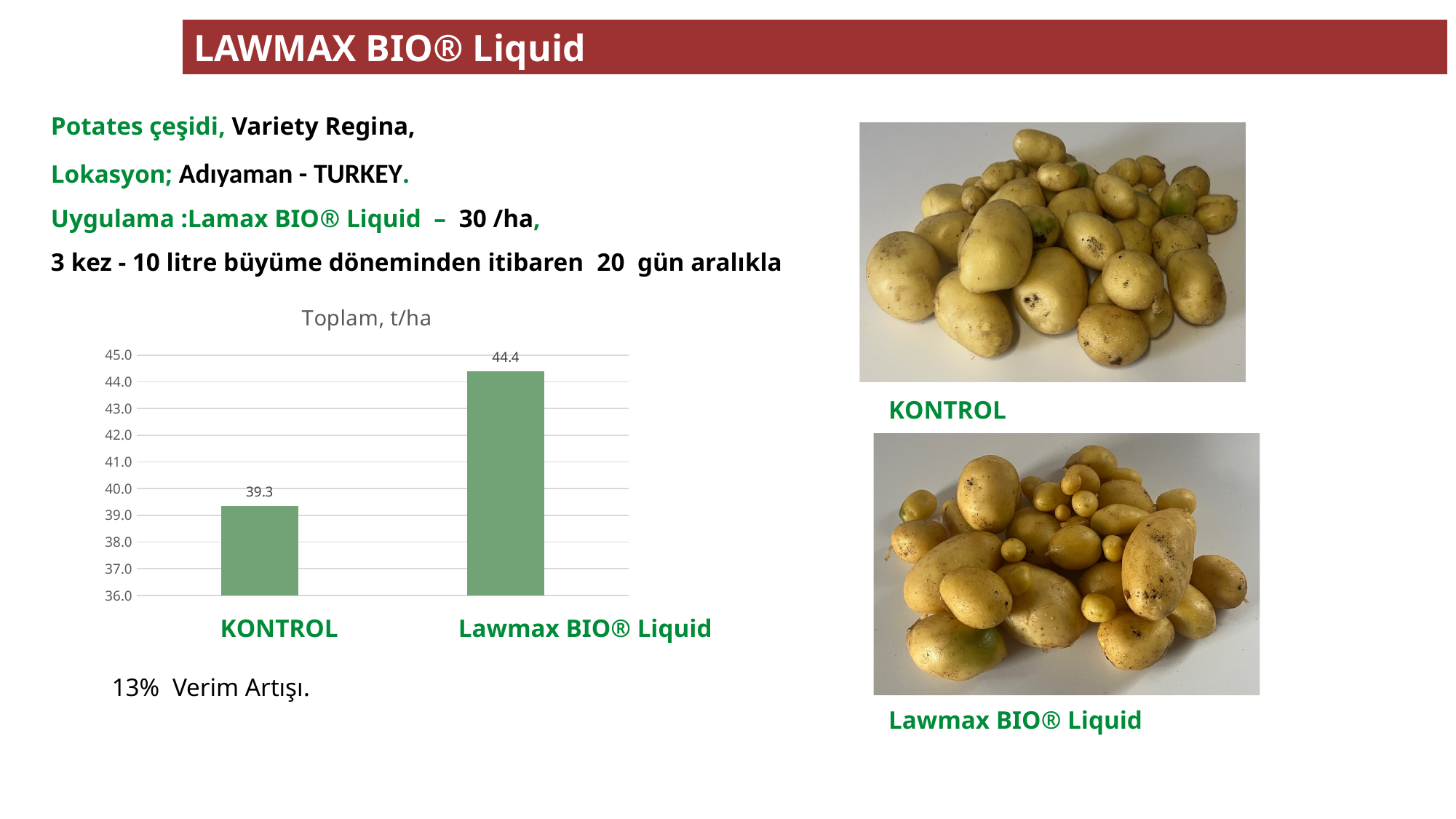
How many categories are shown in the chart? 2 Which is larger, the value for KONTROL or the value for Lawmax BIO® Liquid? Lawmax BIO® Liquid What is the value for KONTROL in the chart? 39.3 What is the difference between the Lawmax BIO® Liquid value and the KONTROL value? 5.1 Is the value for Lawmax BIO® Liquid greater or less than 43.0? greater What is the value for Lawmax BIO® Liquid in the chart? 44.4 What is the highest value shown on the chart's vertical axis? 45.0 Which category has the highest value in the chart? Lawmax BIO® Liquid Is the value for KONTROL greater or less than 40.0? less Which category has the lowest value in the chart? KONTROL What is the title of the chart? Toplam, t/ha What kind of chart is shown on the slide? bar chart